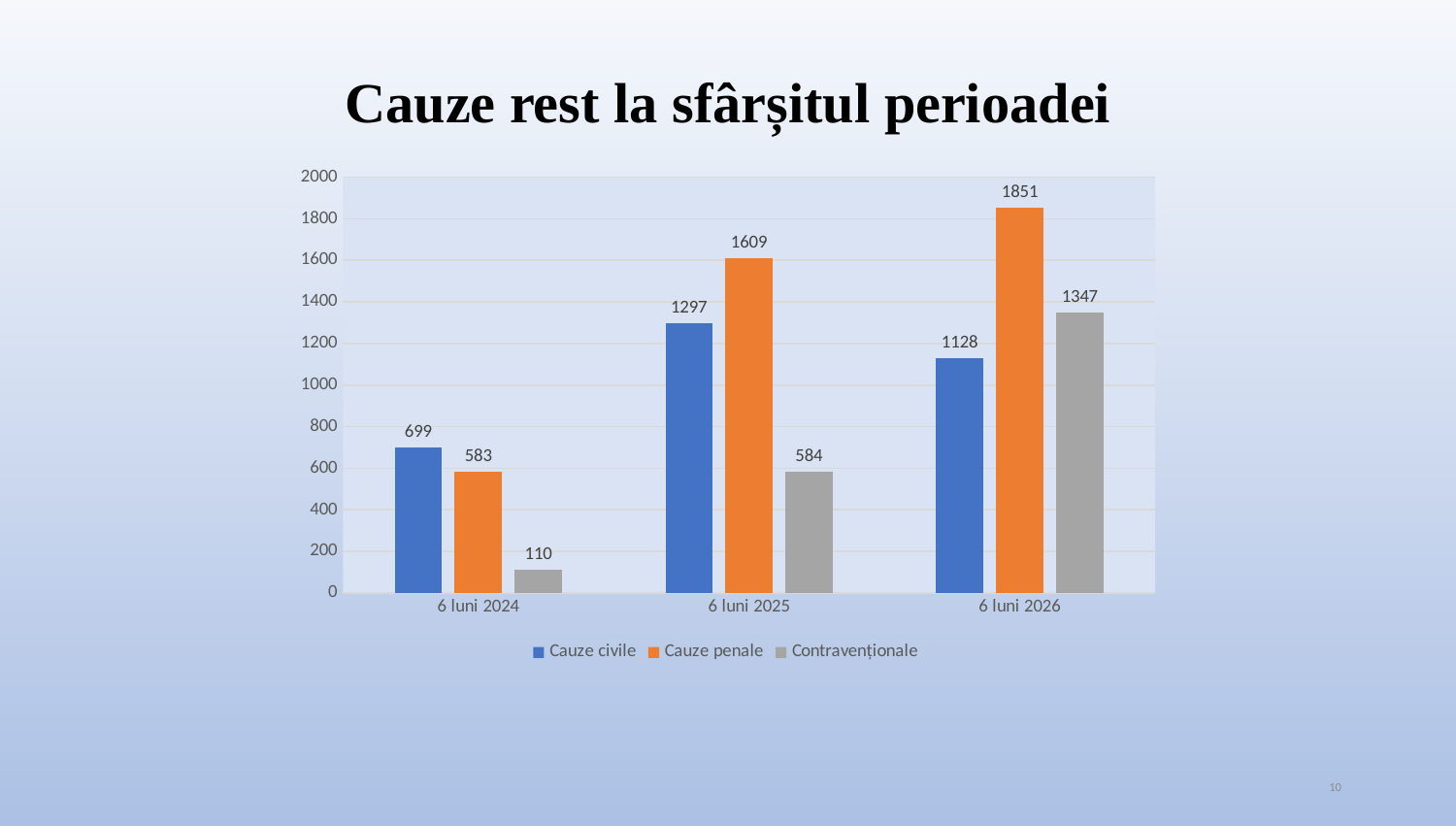
What is the value for Contravenționale in 6 luni 2024? 110 What kind of chart is shown on the slide? Bar chart Which is larger in 6 luni 2024: Cauze civile or Cauze penale? Cauze civile What is the value for Cauze penale in 6 luni 2025? 1609 How many periods are shown on the x axis? 3 How many series does the legend list? 3 Which period has the highest value for Cauze penale? 6 luni 2026 What is the title of the chart? Cauze rest la sfârșitul perioadei What is the difference between Cauze penale and Cauze civile in 6 luni 2026? 723 Which period has the lowest value for Contravenționale? 6 luni 2024 Do the values for Cauze penale rise or fall from 6 luni 2024 to 6 luni 2026? Rise What is the value for Cauze civile in 6 luni 2026? 1128